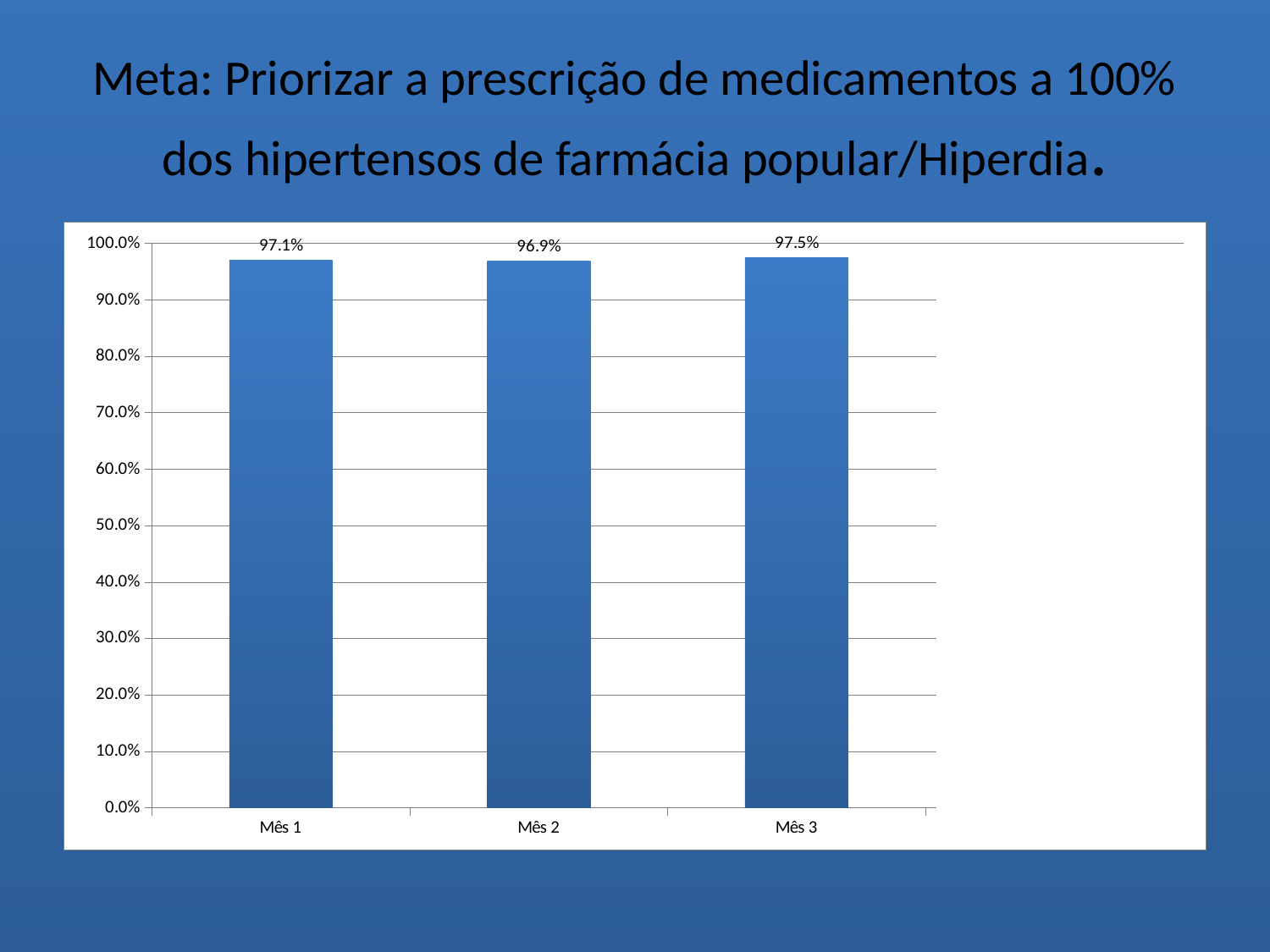
Is the value for Mês 2 greater or less than 90.0%? greater What kind of chart is shown on the slide? bar chart What is the value for Mês 3? 97.5% What is the value for Mês 1? 97.1% What is the difference between the values for Mês 1 and Mês 2? 0.2% What is the difference between the values for Mês 3 and Mês 2? 0.6% Which month has the highest value? Mês 3 Which is larger, the value for Mês 1 or the value for Mês 3? Mês 3 How many months are shown on the x axis? 3 Which month has the lowest value? Mês 2 What is the highest value shown on the y axis? 100.0% What is the value for Mês 2? 96.9%